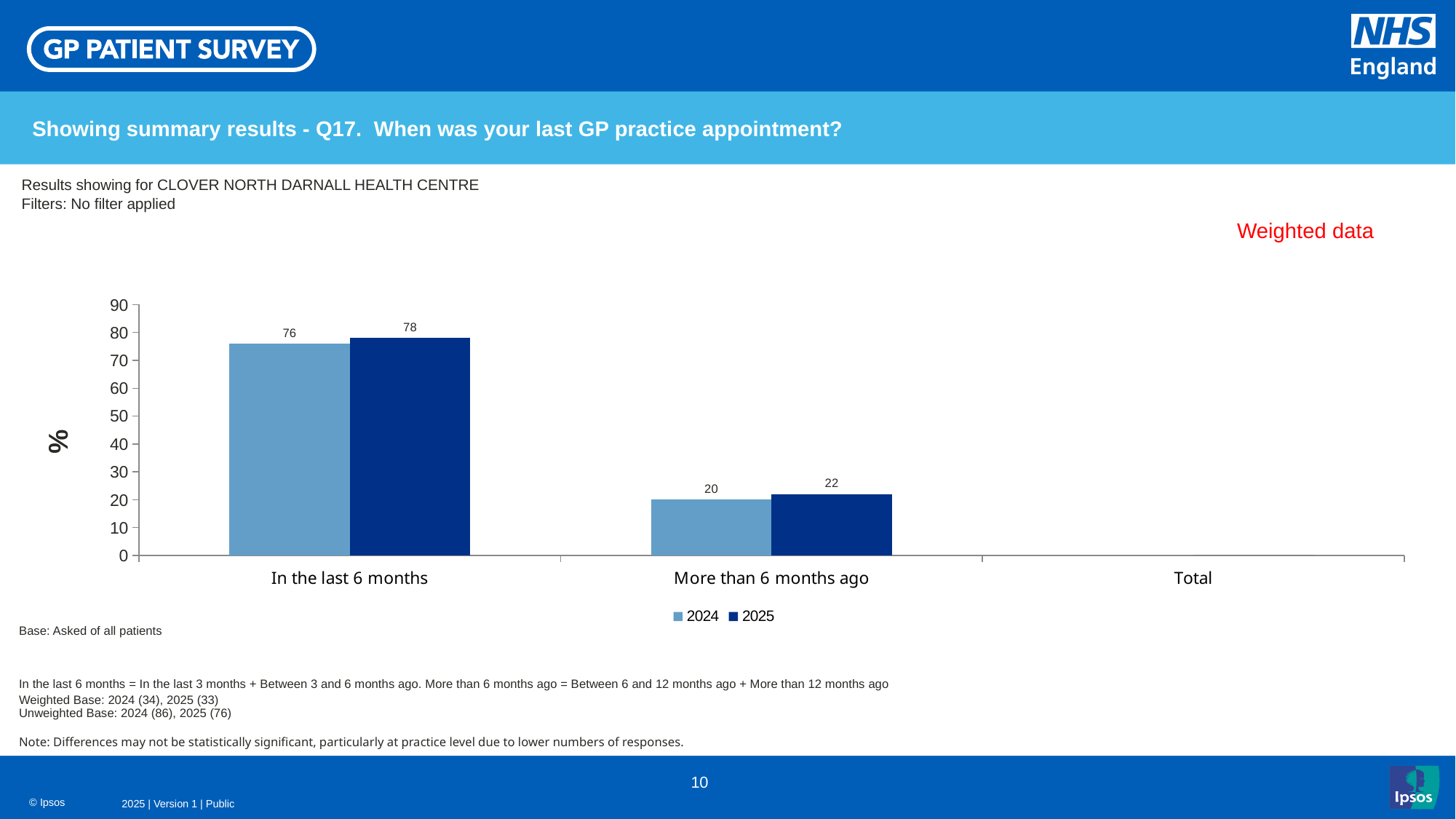
What is the difference between the 2025 and 2024 values for "In the last 6 months"? 2 How many series does the legend list? 2 What kind of chart is shown on the slide? Bar chart Which is larger: the 2024 value or the 2025 value for "More than 6 months ago"? 2025 Which category has the highest value for 2025? In the last 6 months What is the value for 2025 in the "More than 6 months ago" category? 22 Which category has the lowest value for 2024? More than 6 months ago What is the value for 2024 in the "More than 6 months ago" category? 20 What is the value for 2025 in the "In the last 6 months" category? 78 What label is shown on the vertical axis of the chart? % What is the value for 2024 in the "In the last 6 months" category? 76 What is the difference between the 2024 values for "In the last 6 months" and "More than 6 months ago"? 56